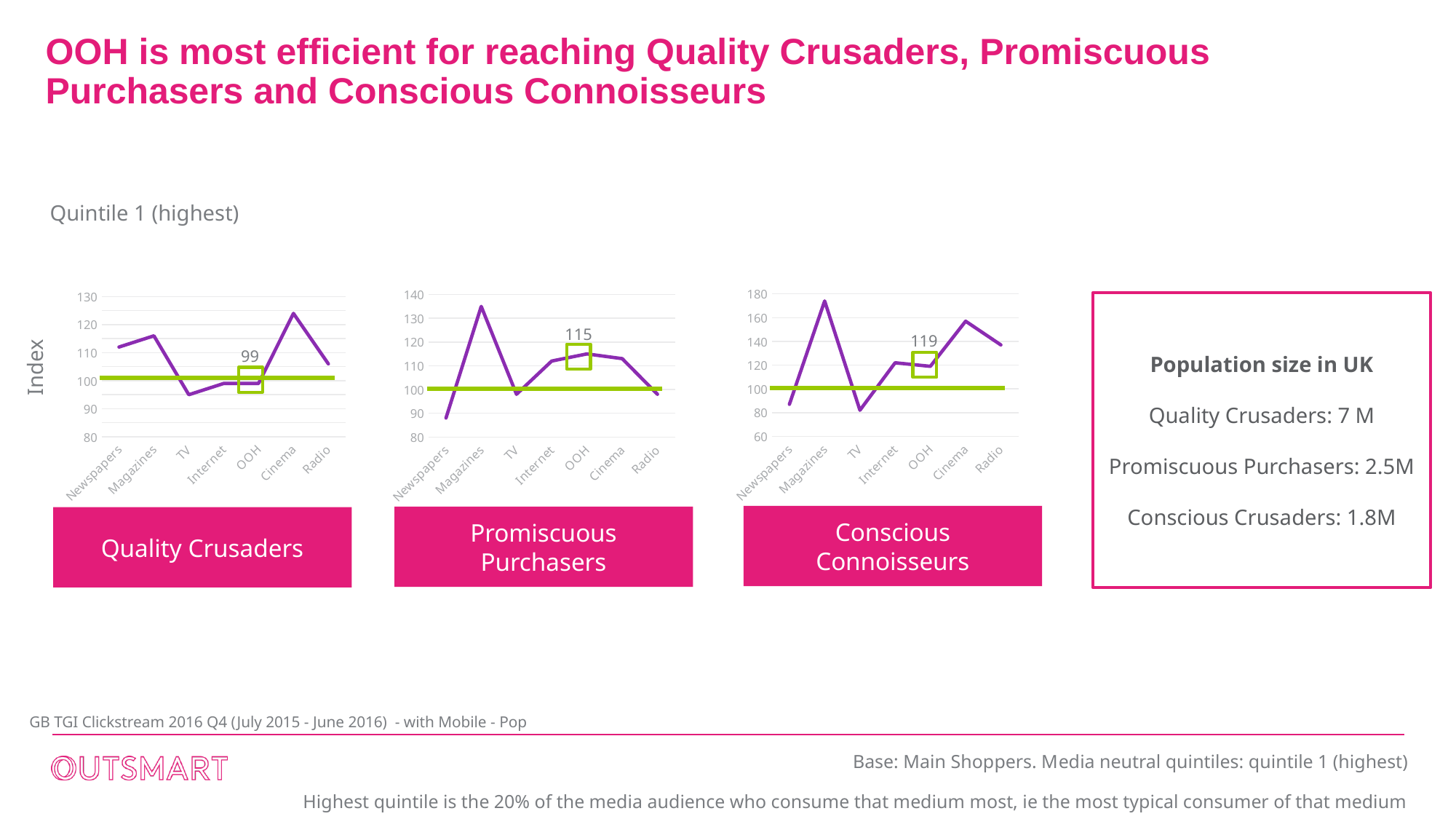
Which OOH index value is larger: Promiscuous Purchasers or Conscious Connoisseurs? Conscious Connoisseurs How many media categories are plotted on the x axis of the Quality Crusaders chart? 7 In the Promiscuous Purchasers chart, what is the index value labelled for OOH? 115 In the Conscious Connoisseurs chart, which medium has the lowest index? TV In the Promiscuous Purchasers chart, which medium has the highest index? Magazines In the Conscious Connoisseurs chart, what is the index value labelled for OOH? 119 In the Quality Crusaders chart, which medium has the highest index? Cinema In the Conscious Connoisseurs chart, is the value for Magazines greater or less than 160? greater In the Quality Crusaders chart, what is the index value labelled for OOH? 99 In the Quality Crusaders chart, is the value for Cinema greater or less than 120? greater In the Promiscuous Purchasers chart, is the value for Newspapers greater or less than 100? less What kind of chart is used for the Conscious Connoisseurs data? Line chart